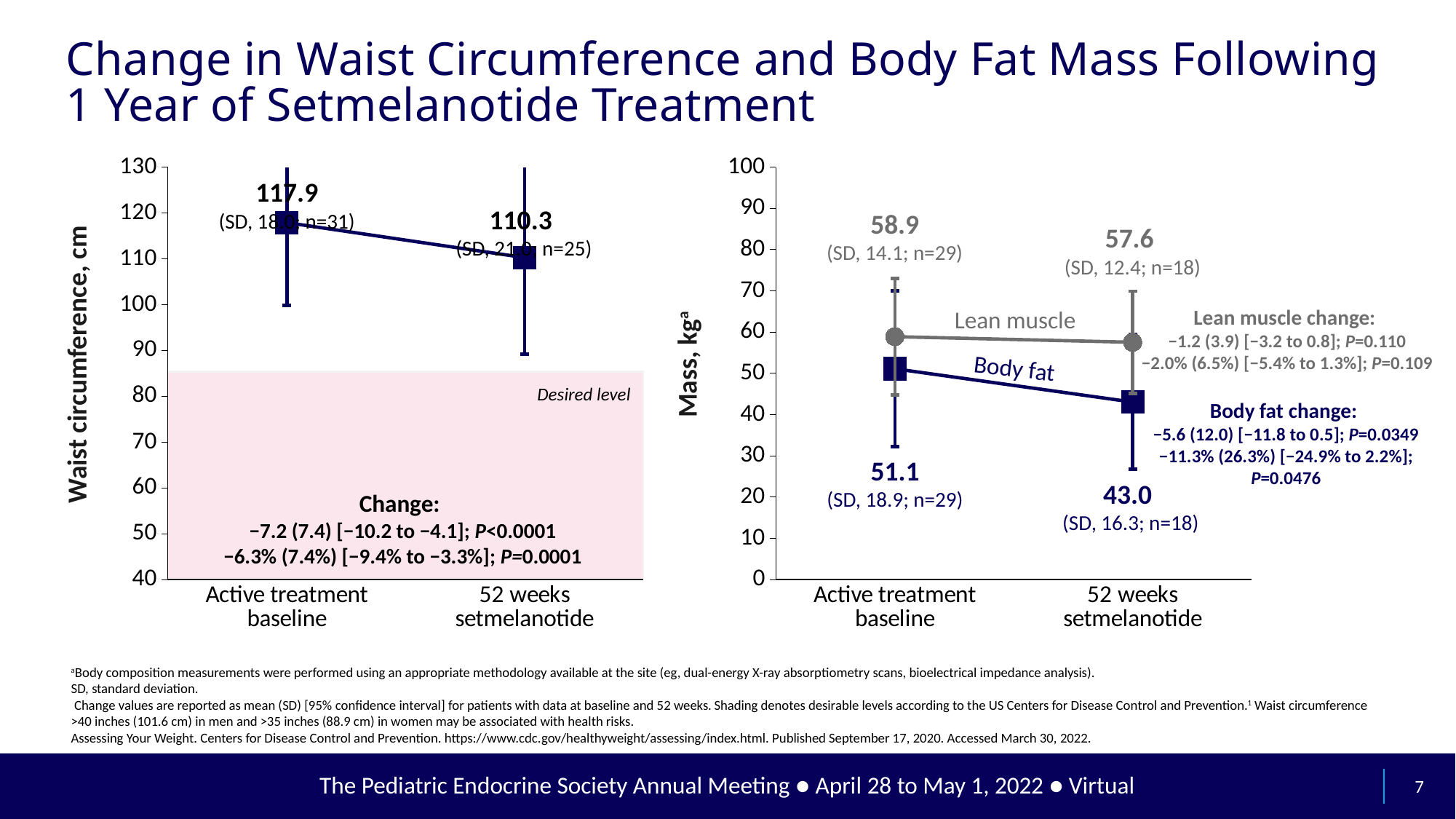
In the right chart (mass), is the body fat mass at 52 weeks setmelanotide greater or less than 50? less In the right chart (mass), which is larger at 52 weeks setmelanotide: lean muscle mass or body fat mass? lean muscle In the left chart (waist circumference), what is the mean waist circumference at 52 weeks setmelanotide? 110.3 What kind of chart is the left chart (waist circumference)? line chart In the left chart (waist circumference), does the plotted value rise or fall from baseline to 52 weeks? fall How many series are plotted in the right chart (mass)? 2 In the right chart (mass), what is the mean body fat mass at 52 weeks setmelanotide? 43.0 In the left chart (waist circumference), what is the mean waist circumference at active treatment baseline? 117.9 In the right chart (mass), what is the mean lean muscle mass at active treatment baseline? 58.9 In the right chart (mass), what is the mean lean muscle mass at 52 weeks setmelanotide? 57.6 In the right chart (mass), what is the difference between the lean muscle mass and the body fat mass at active treatment baseline? 7.8 In the left chart (waist circumference), how many patients (n) are reported at active treatment baseline? n=31